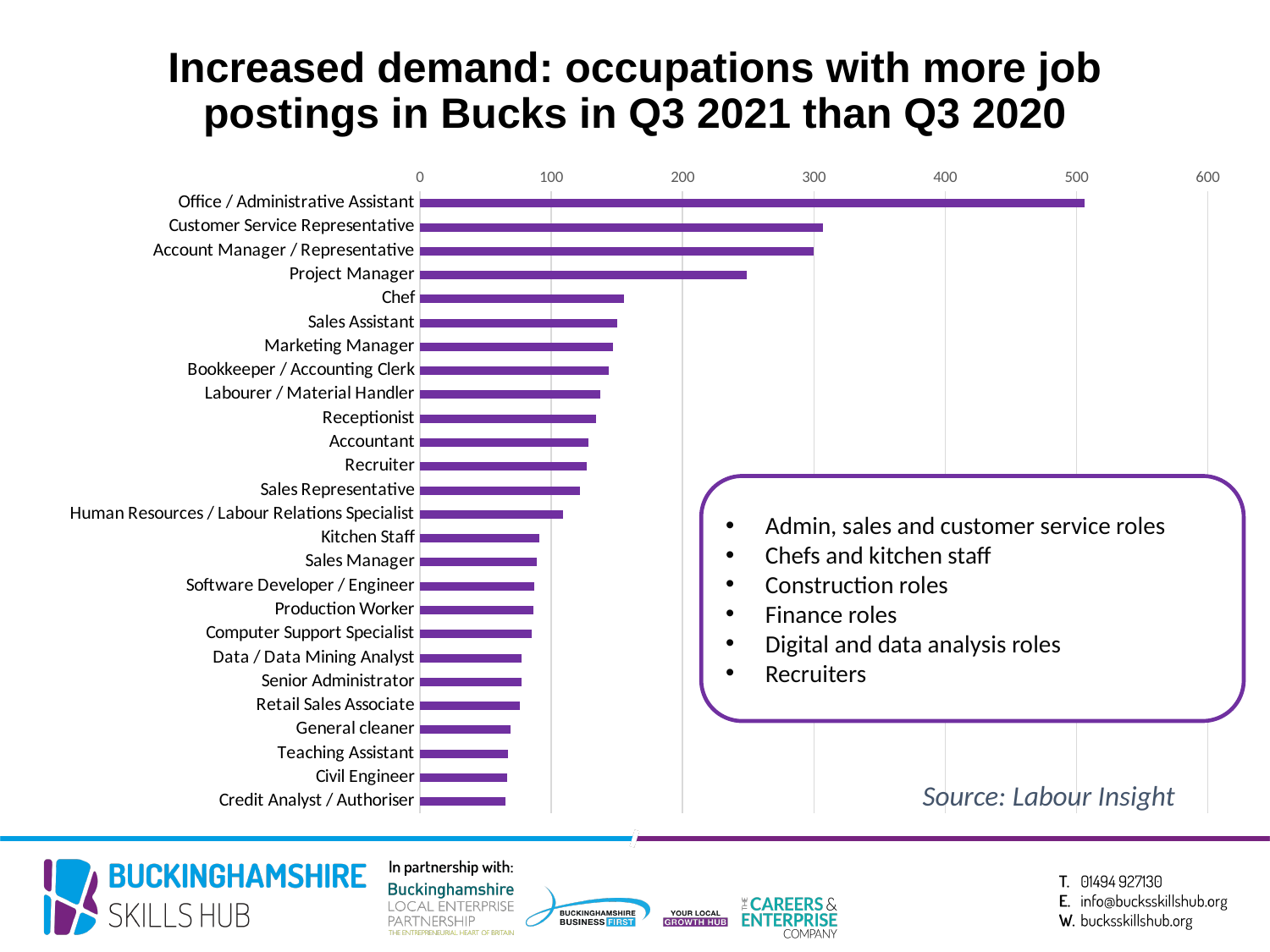
Is the value for Project Manager greater or less than 300? less Is the value for Credit Analyst / Authoriser greater or less than 100? less What kind of chart is shown on the slide? bar chart Which has a larger value, Office / Administrative Assistant or Project Manager? Office / Administrative Assistant Is the value for Office / Administrative Assistant greater or less than 400? greater Which occupation has the highest number of job postings in the chart? Office / Administrative Assistant What is the source cited for the chart data? Labour Insight Which has a larger value, Chef or Kitchen Staff? Chef How many occupations are listed in the chart? 26